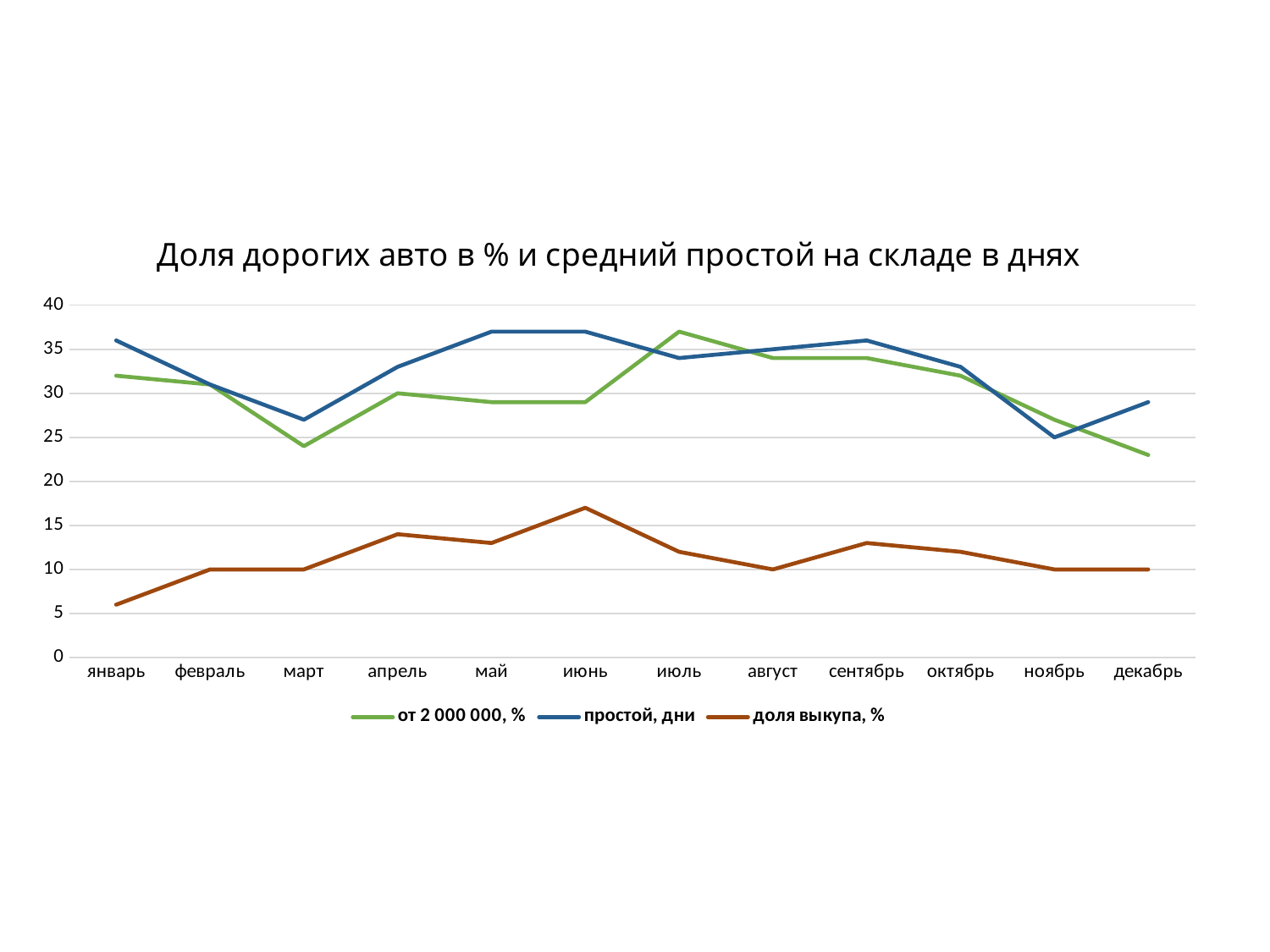
Is the value of 'простой, дни' in декабрь greater or less than 30? less Is the value of 'от 2 000 000, %' in март greater or less than 25? less How many series does the legend list? 3 In март, which series is higher: 'простой, дни' or 'от 2 000 000, %'? простой, дни What is the title of the chart? Доля дорогих авто в % и средний простой на складе в днях In which month is the series 'доля выкупа, %' at its lowest? январь What kind of chart is shown on the slide? line chart In which month does the series 'доля выкупа, %' reach its highest value? июнь What is the value of 'доля выкупа, %' in февраль? 10 Does the series 'доля выкупа, %' rise or fall from январь to июнь? rise Is the value of 'доля выкупа, %' in июнь greater or less than 15? greater How many months are plotted along the x axis? 12